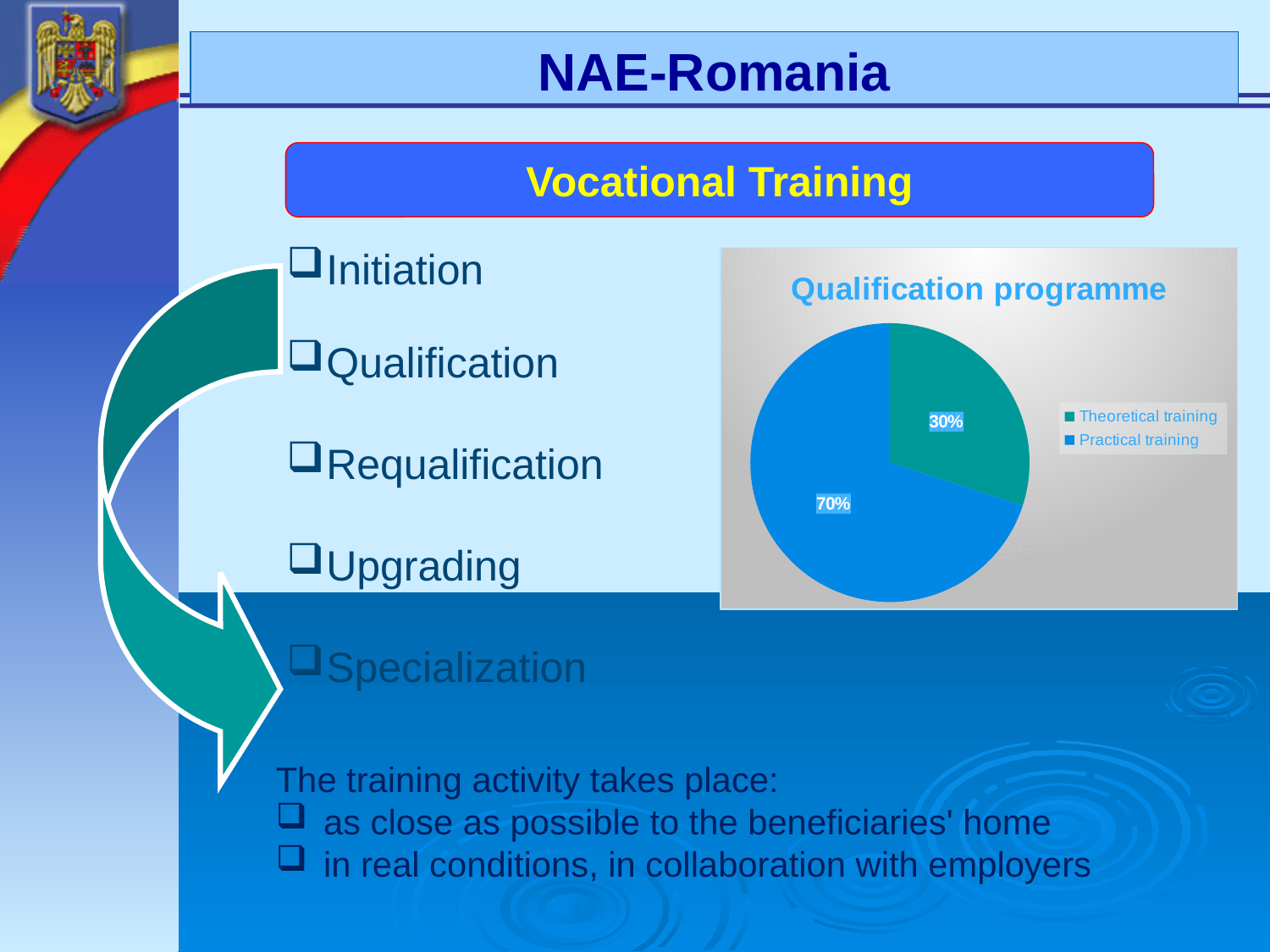
Which is larger, Theoretical training or Practical training? Practical training How many slices does the pie chart have? 2 What share of the pie does Theoretical training take? 30% Which slice of the pie is the smallest? Theoretical training What kind of chart is shown under the title "Qualification programme"? pie chart What is the title of the chart on the slide? Qualification programme What share of the pie does Practical training take? 70% What colour is the Theoretical training slice in the pie chart? teal (green) What is the difference in percentage points between Practical training and Theoretical training? 40 percentage points How many entries does the legend list? 2 Which slice of the pie is the largest? Practical training